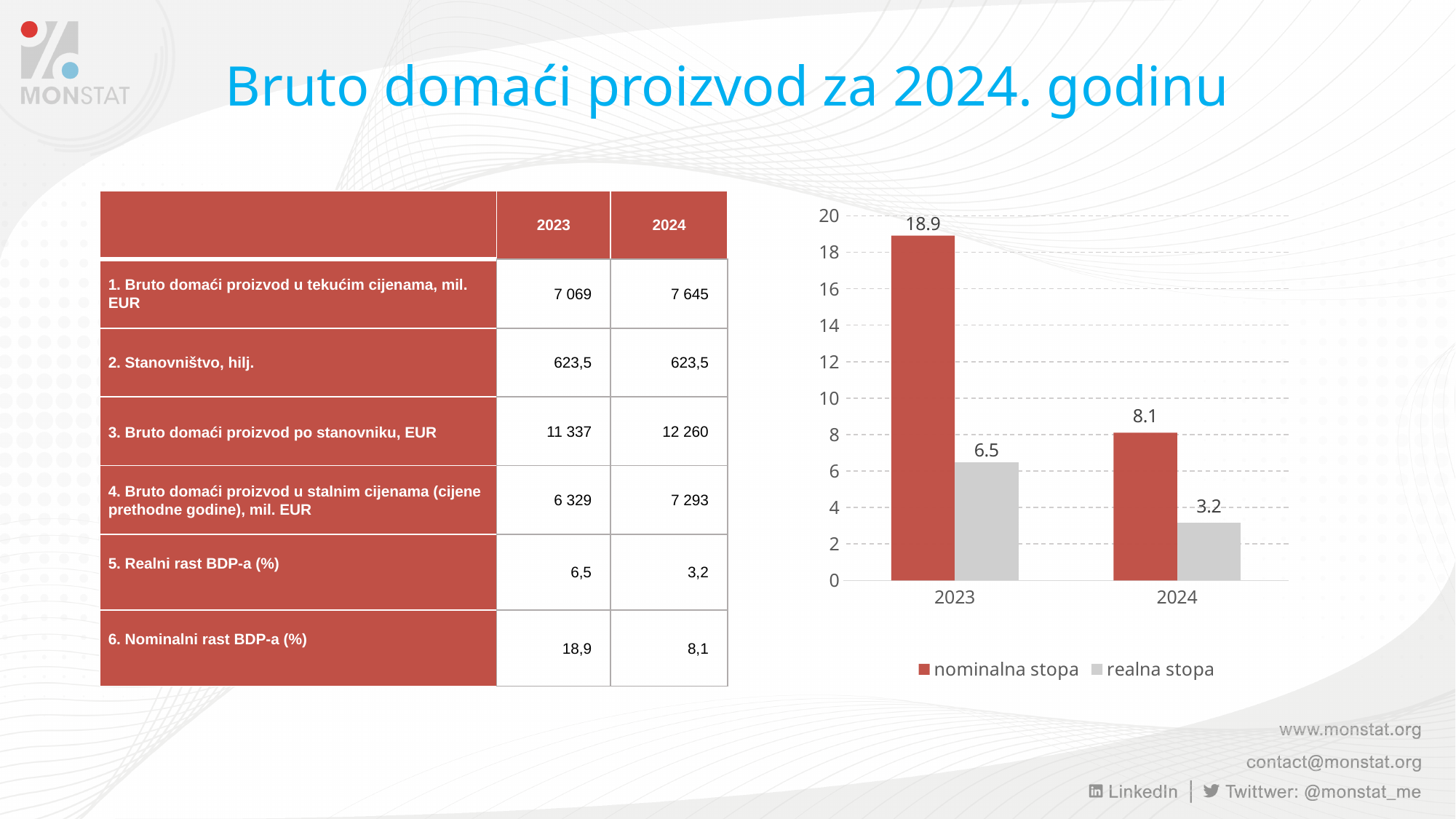
Which is larger in 2023: nominalna stopa or realna stopa? nominalna stopa Does the nominalna stopa rise or fall from 2023 to 2024? fall What kind of chart is shown on the slide? bar chart What is the difference between nominalna stopa and realna stopa in 2024? 4.9 What is the value of realna stopa for 2024? 3.2 What is the value of realna stopa for 2023? 6.5 What is the value of nominalna stopa for 2023? 18.9 What is the value of nominalna stopa for 2024? 8.1 Which year has the highest nominalna stopa? 2023 Which year has the lowest realna stopa? 2024 How many series does the legend list? 2 What is the difference between nominalna stopa in 2023 and 2024? 10.8